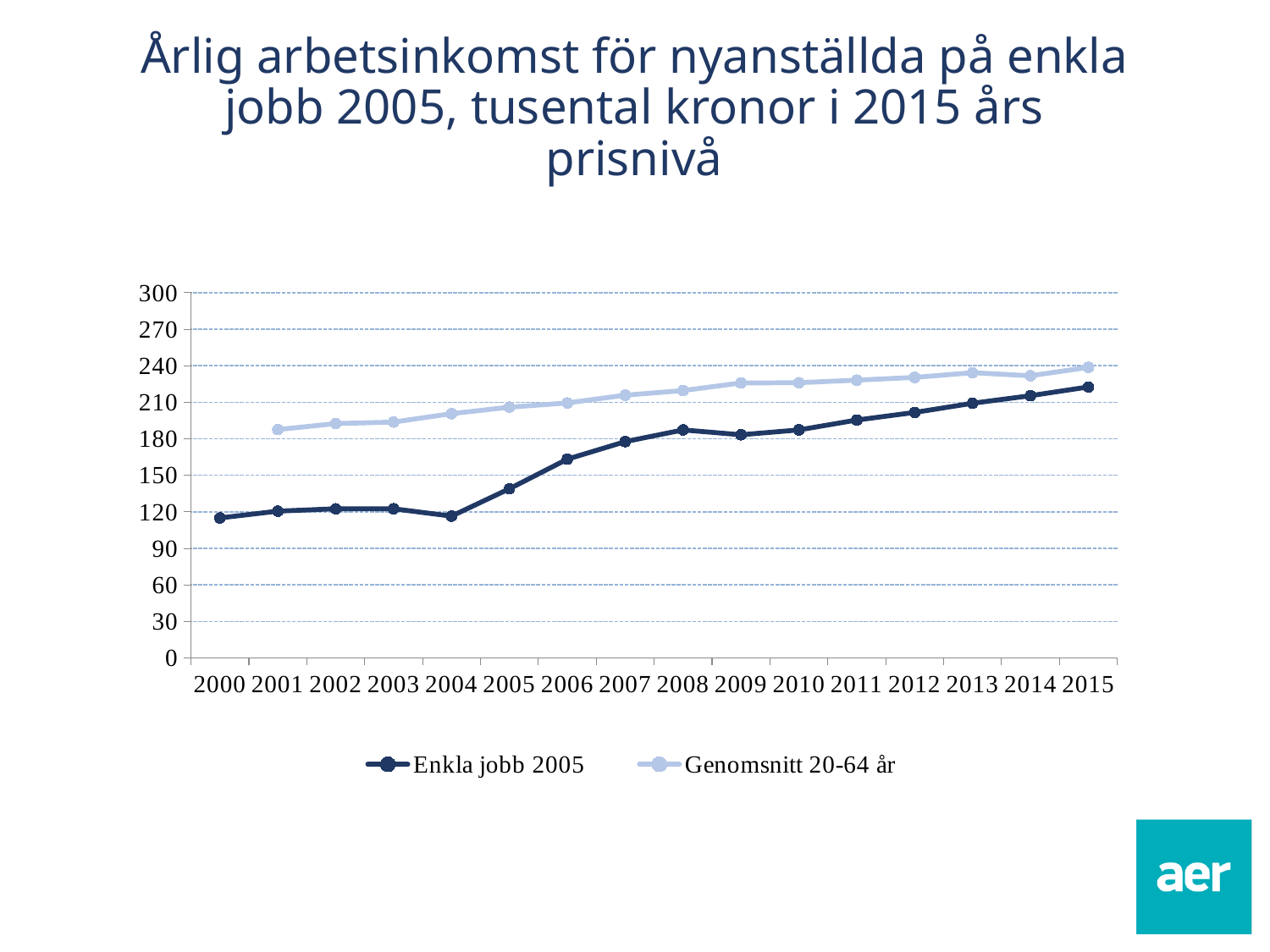
In which year is the value for Enkla jobb 2005 highest? 2015 Is the value for Genomsnitt 20-64 år in 2001 greater or less than 210? less Which series is plotted with the darker line? Enkla jobb 2005 How many series does the legend list? 2 Does the value for Enkla jobb 2005 generally rise or fall from 2000 to 2015? rise In which year is the value for Genomsnitt 20-64 år lowest? 2001 Is the value for Genomsnitt 20-64 år in 2009 greater or less than 210? greater Is the value for Enkla jobb 2005 in 2000 greater or less than 120? less What kind of chart is shown on the slide? line chart In 2010, which series has the larger value, Enkla jobb 2005 or Genomsnitt 20-64 år? Genomsnitt 20-64 år How many years are shown on the x axis? 16